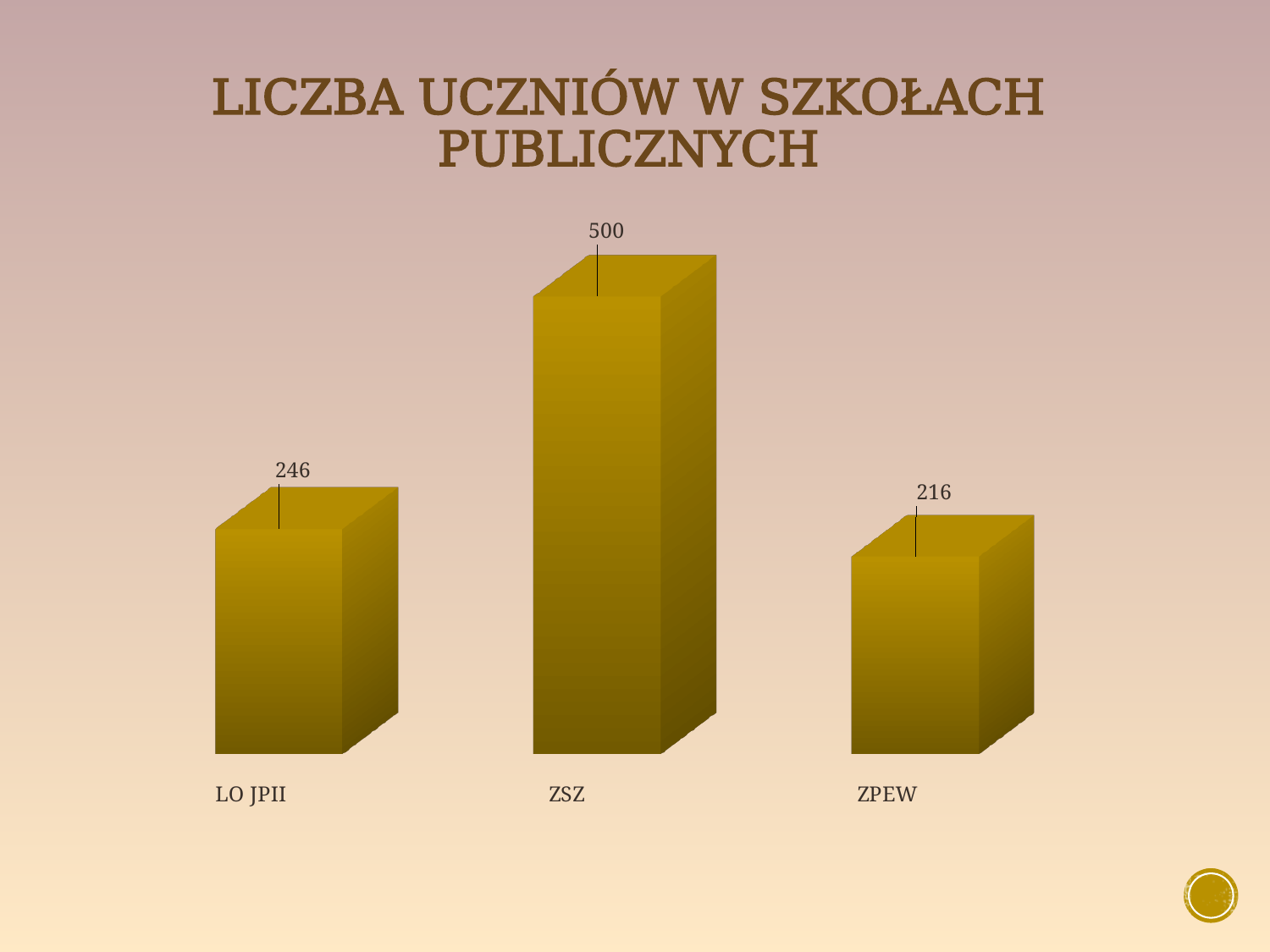
What is the total number of students across all three schools? 962 Which is larger, the value for LO JPII or the value for ZPEW? LO JPII What is the value for ZPEW? 216 Which school has the lowest number of students? ZPEW Which school has the highest number of students? ZSZ How many categories are shown in the chart? 3 What is the value for ZSZ? 500 What is the difference between the values for ZSZ and LO JPII? 254 What is the difference between the values for LO JPII and ZPEW? 30 What is the value for LO JPII? 246 What kind of chart is shown on the slide? bar chart What is the title of the chart? LICZBA UCZNIÓW W SZKOŁACH PUBLICZNYCH